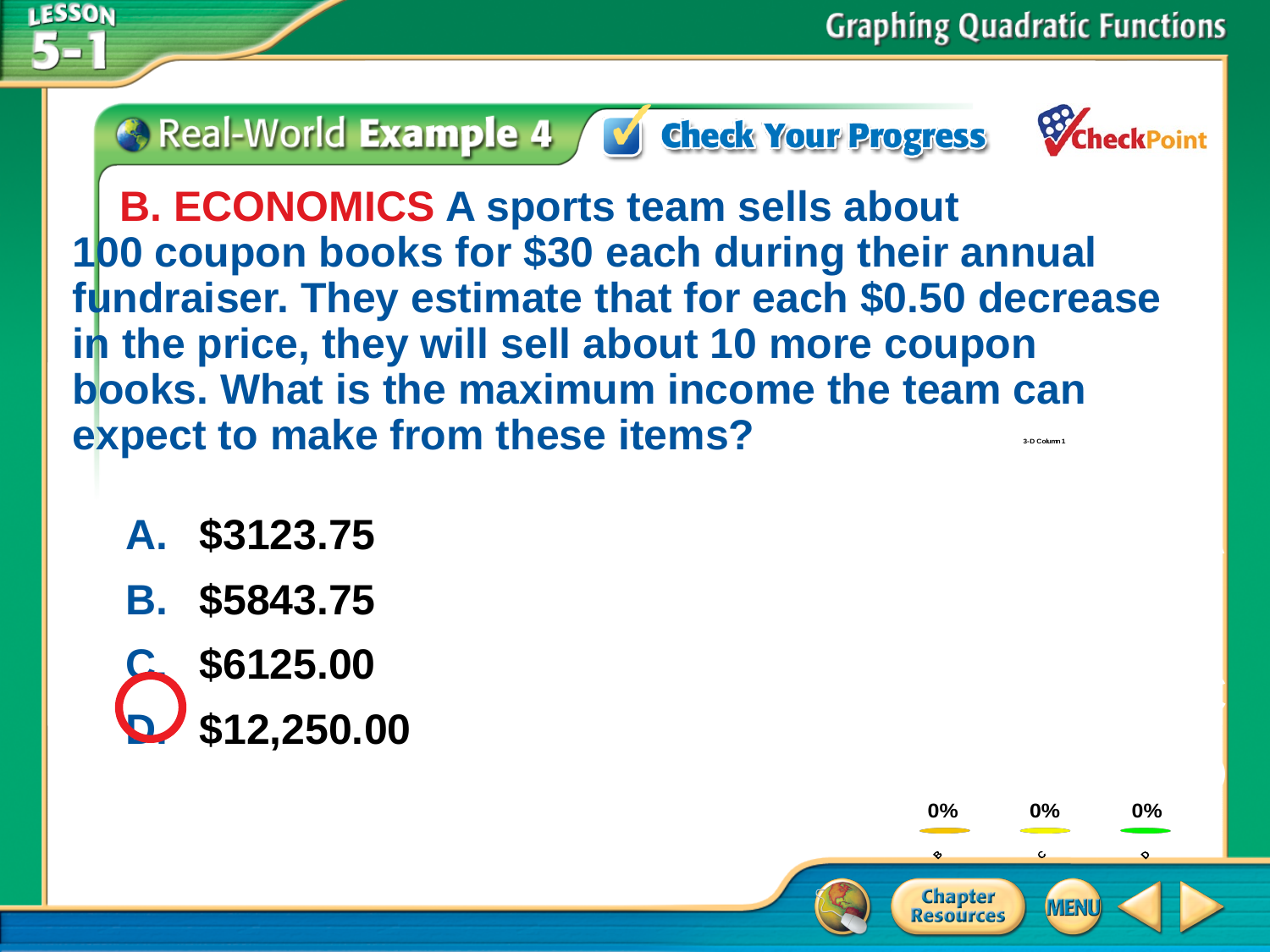
What is the total of the three bar values in the chart at the bottom right? 0% What value is labelled on the leftmost bar of the chart at the bottom right? 0% How many bars does the chart at the bottom right of the slide show? 3 What value is labelled on the rightmost bar of the chart at the bottom right? 0% What colour is the rightmost bar in the chart at the bottom right? green What kind of chart is shown at the bottom right of the slide? bar chart What is the difference between the values of the leftmost and rightmost bars in the chart at the bottom right? 0% What value is labelled on the middle bar of the chart at the bottom right? 0%